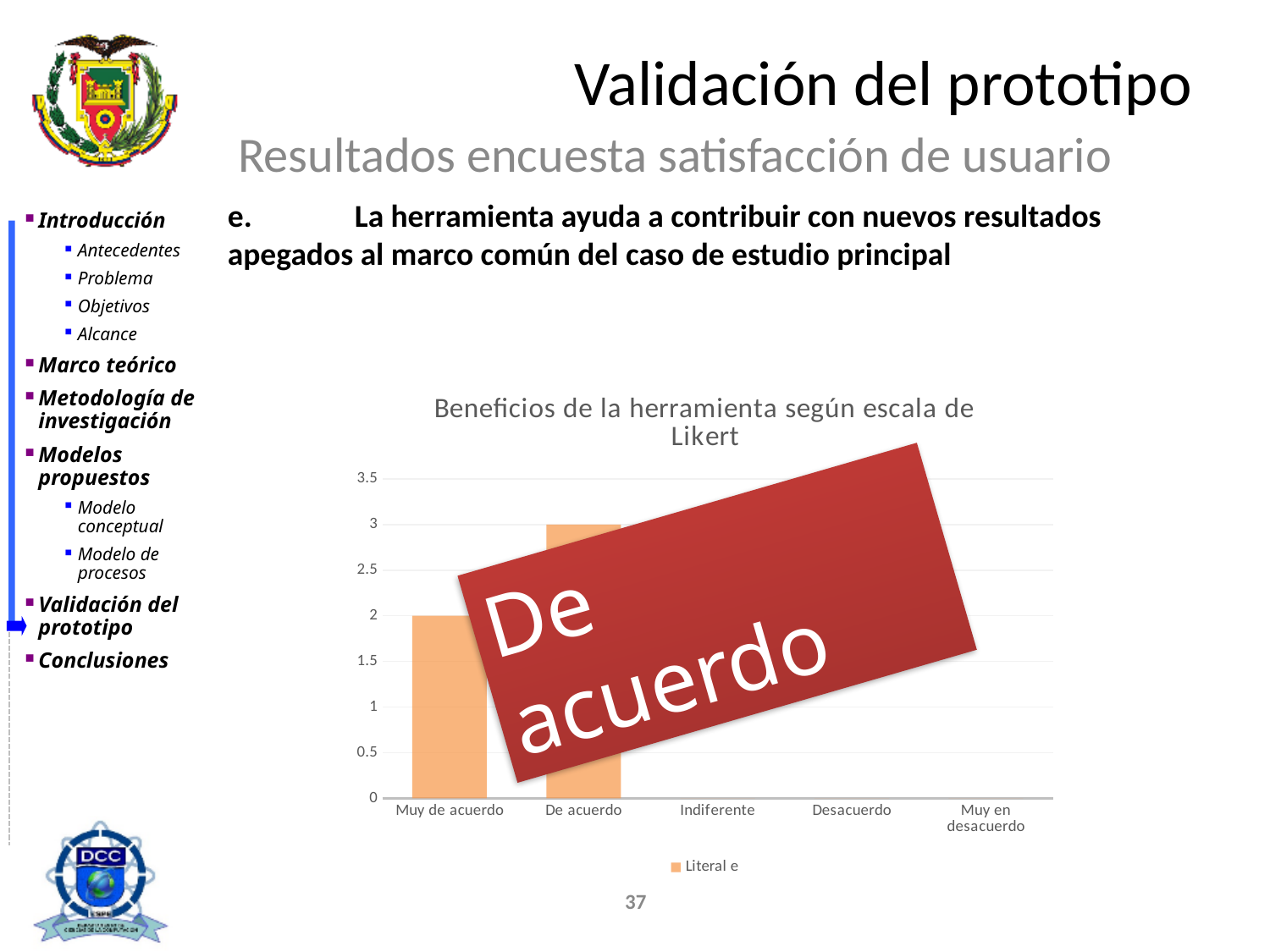
What is the value for "Muy de acuerdo"? 2 Which category has the highest value? De acuerdo What is the value for "De acuerdo"? 3 What type of chart is shown on the slide? bar chart Is the value for "De acuerdo" greater or less than 2.5? greater Is the value for "Muy de acuerdo" greater or less than 2.5? less What is the difference between the values for "De acuerdo" and "Muy de acuerdo"? 1 What is the title of the chart? Beneficios de la herramienta según escala de Likert What is the name of the series shown in the chart legend? Literal e How many series does the chart legend list? 1 Which is larger, the value for "Muy de acuerdo" or the value for "De acuerdo"? De acuerdo How many categories are shown on the x axis of the chart? 5